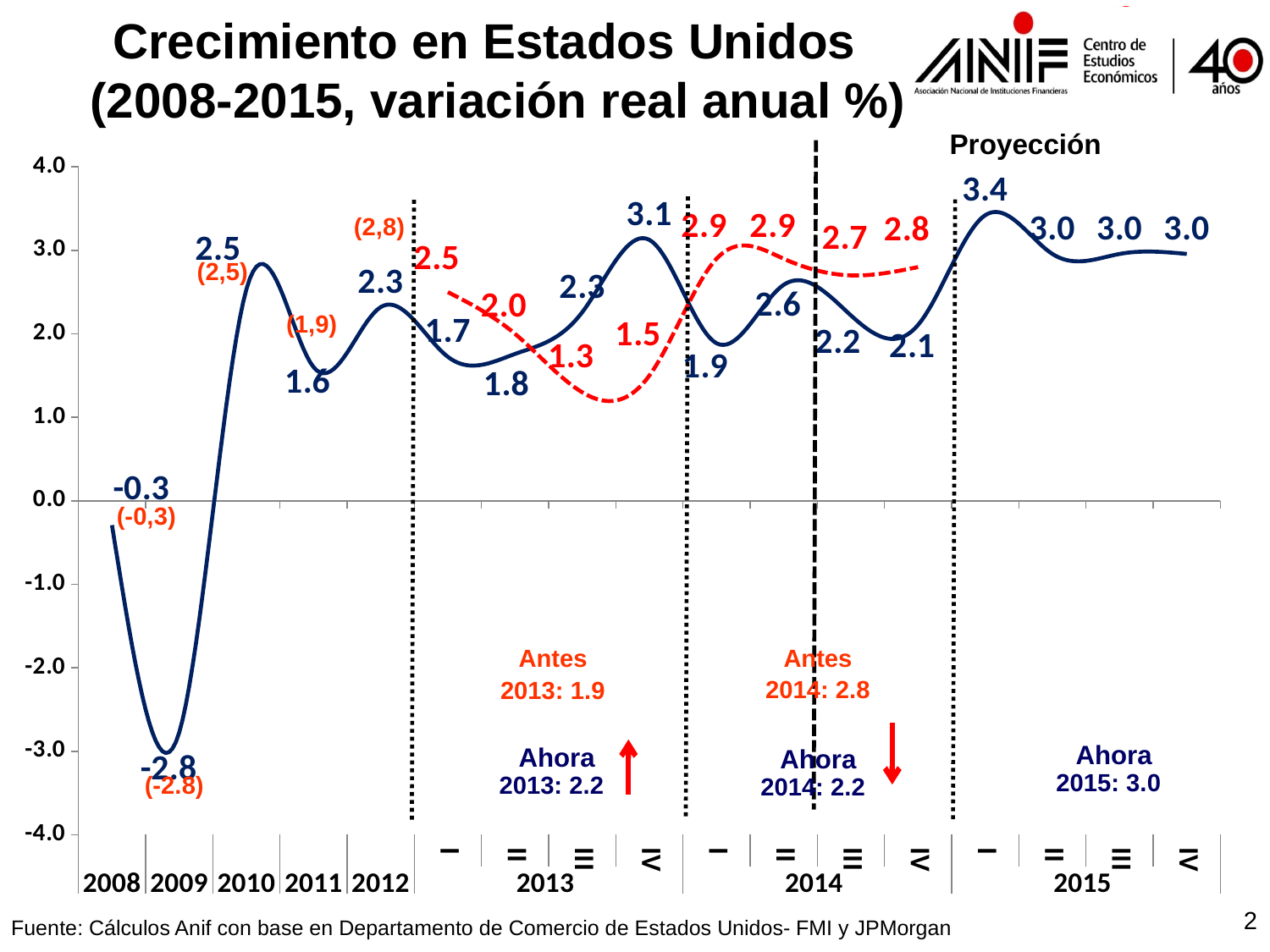
Which year or quarter has the lowest value on the blue line? 2009 Which quarter has the highest value on the blue line? 2015 I What is the value of the blue line for 2009? -2.8 What is the value of the red dashed line for the third quarter (III) of 2013? 1.3 What is the value of the blue line for the first quarter (I) of 2015? 3.4 What kind of chart is shown on the slide? line chart According to the annotation, what is the 'Ahora' projection for 2014? 2.2 Which is larger, the blue line value for the second quarter (II) of 2014 or the fourth quarter (IV) of 2014? 2014 II Does the blue line rise or fall from 2008 to 2009? fall What is the value of the blue line for the fourth quarter (IV) of 2013? 3.1 What is the title of the chart? Crecimiento en Estados Unidos (2008-2015, variación real anual %) What is the difference between the blue line value for 2010 (2.5) and for 2011 (1.6)? 0.9